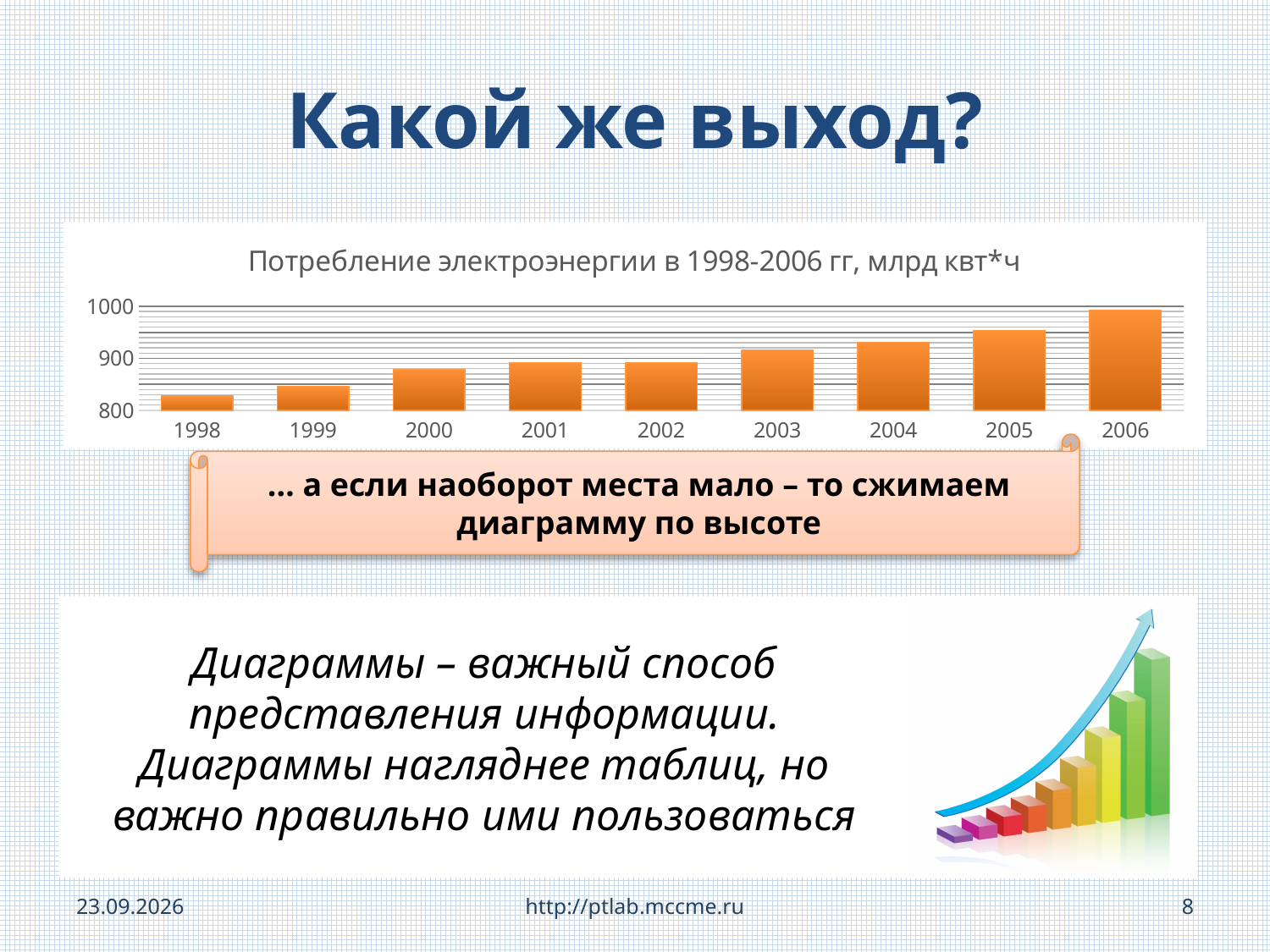
What is the title of the chart? Потребление электроэнергии в 1998-2006 гг, млрд квт*ч Do the values in the chart generally rise or fall from 1998 to 2006? rise Which year has the highest electricity consumption in the chart? 2006 Which is larger, the value for 2005 or the value for 1999? 2005 Which year has the lowest electricity consumption in the chart? 1998 Is the value for 2006 greater or less than 900? greater Is the value for 2000 greater or less than 900? less How many years are shown on the x axis of the chart? 9 Which is larger, the value for 2000 or the value for 2003? 2003 What kind of chart is shown on the slide? bar chart Is the value for 1998 greater or less than 900? less